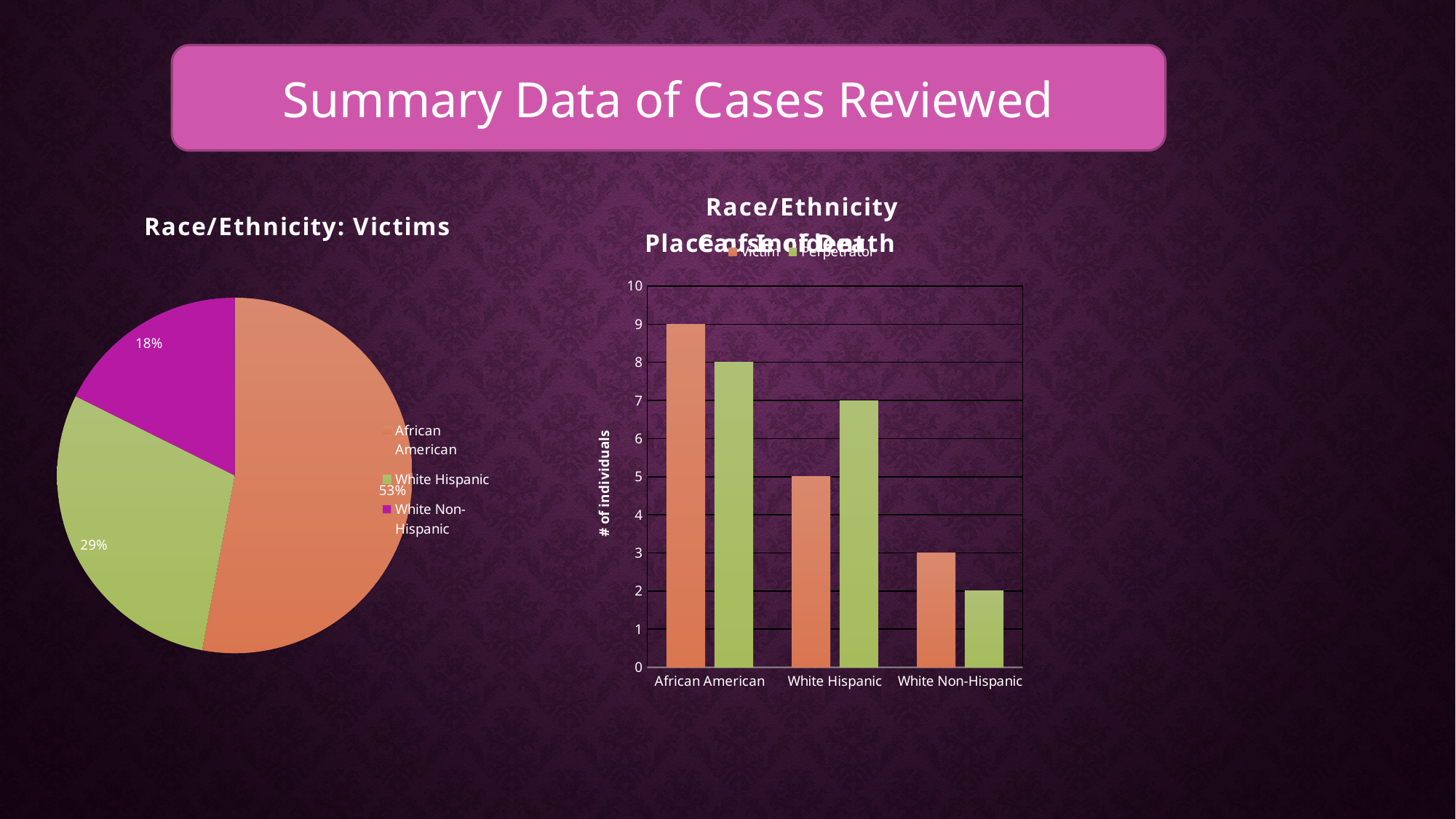
In the bar chart on the right, is the Victim value for White Hispanic larger or smaller than the Perpetrator value for White Hispanic? Smaller What kind of chart is the chart on the right side of the slide? Bar chart In the bar chart on the right, which category has the lowest Perpetrator value? White Non-Hispanic In the bar chart on the right, what is the label of the vertical axis? # of individuals In the pie chart titled Race/Ethnicity: Victims, what is the difference in percentage points between the African American and White Non-Hispanic slices? 35 In the pie chart titled Race/Ethnicity: Victims, what percentage is shown for White Hispanic? 29% In the pie chart titled Race/Ethnicity: Victims, which category has the smallest slice? White Non-Hispanic In the bar chart on the right, how many series does the legend list? 2 In the pie chart titled Race/Ethnicity: Victims, what share of victims is African American? 53% In the pie chart titled Race/Ethnicity: Victims, how many slices does the pie have? 3 In the bar chart on the right, what is the Perpetrator value for White Hispanic? 7 In the bar chart on the right, what is the Victim value for African American? 9